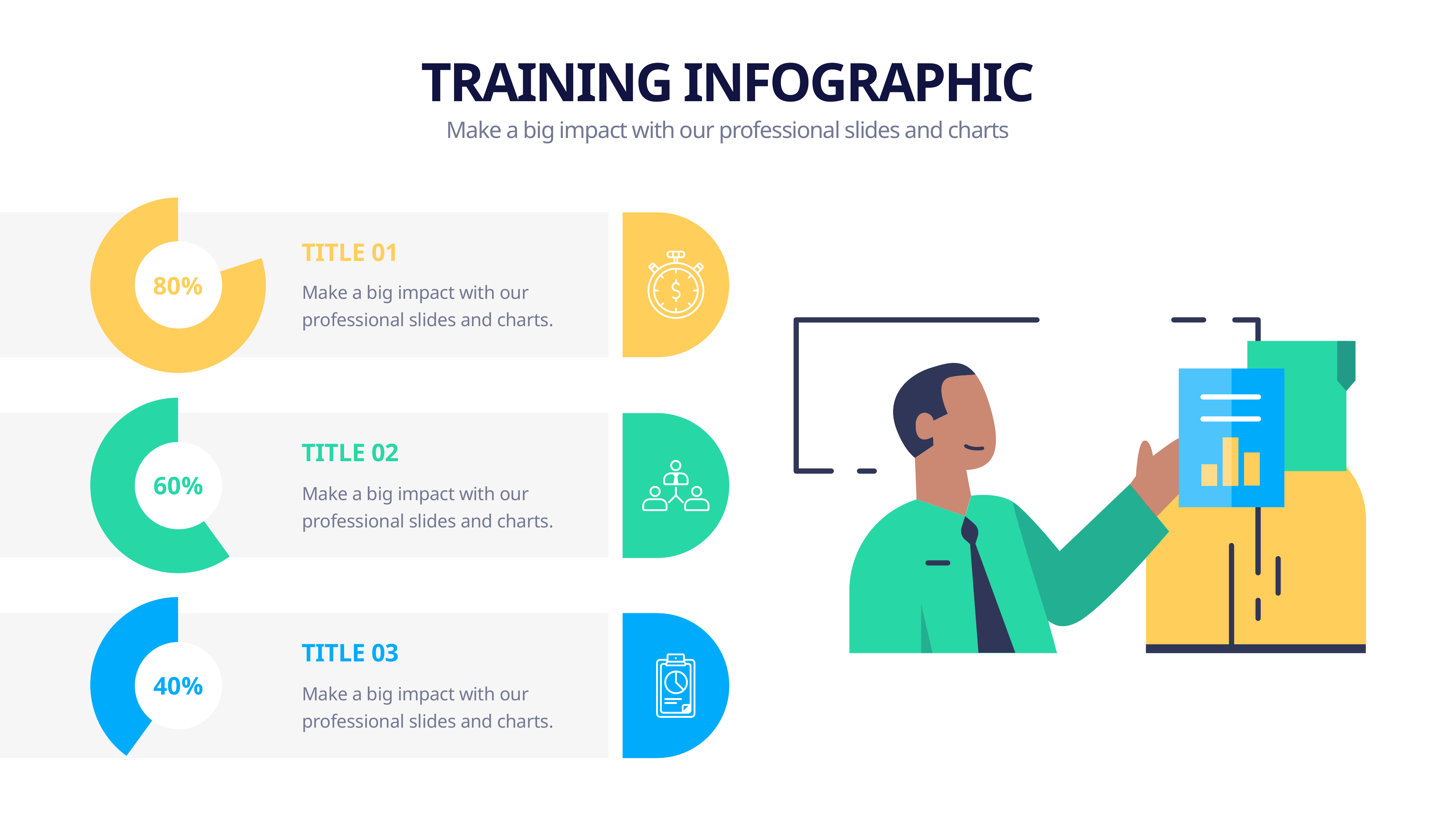
Which has the larger percentage, Title 02 or Title 03? Title 02 What kind of chart is used to show the percentages on the left of the slide? Donut chart What is the difference between the percentages for Title 01 and Title 02? 20% How many donut charts are shown on the slide? 3 What colour is the donut chart for Title 02? Green Which title has the lowest percentage among the three donut charts? Title 03 What percentage is shown in the donut chart for Title 02? 60% What percentage is shown in the donut chart for Title 03? 40% What percentage is shown in the donut chart for Title 01? 80% Do the percentages rise or fall going from Title 01 down to Title 03? Fall What is the difference between the percentages for Title 01 and Title 03? 40% Which title has the highest percentage among the three donut charts? Title 01